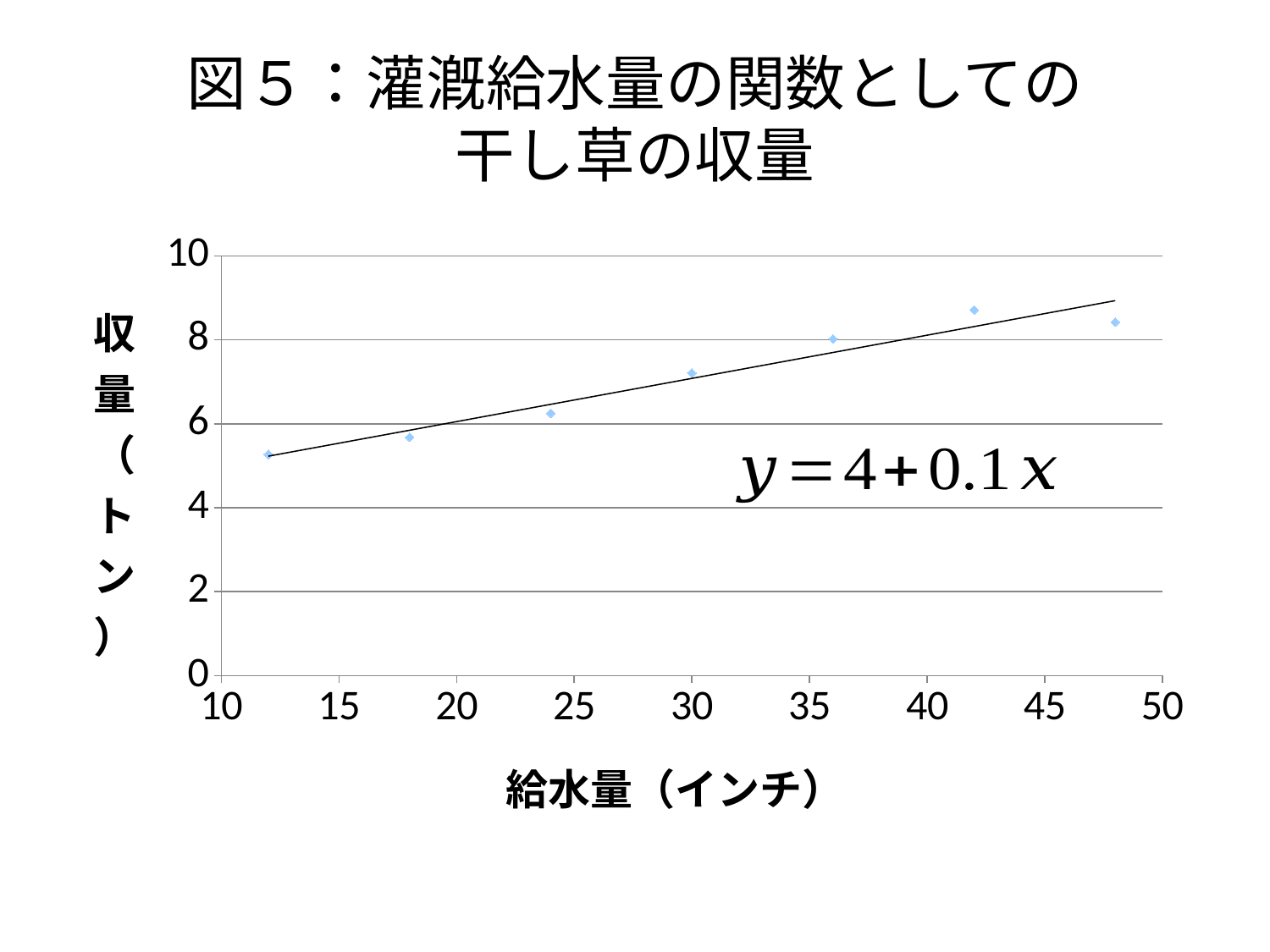
Is the yield value at a water supply of 30 inches greater or less than 6? greater At which water supply value (x) is the plotted yield lowest? 12 What equation of the fitted line is printed on the chart? y = 4 + 0.1x Is the yield value at a water supply of 12 inches greater or less than 6? less What is the label of the x axis? 給水量（インチ） How many data points are plotted on the chart? 7 Which has the larger plotted yield: a water supply of 36 inches or 24 inches? 36 inches Is the yield value at a water supply of 18 inches greater or less than 6? less Do the plotted values generally rise or fall as the water supply (給水量) increases along the x axis? rise What kind of chart is shown on the slide? scatter plot